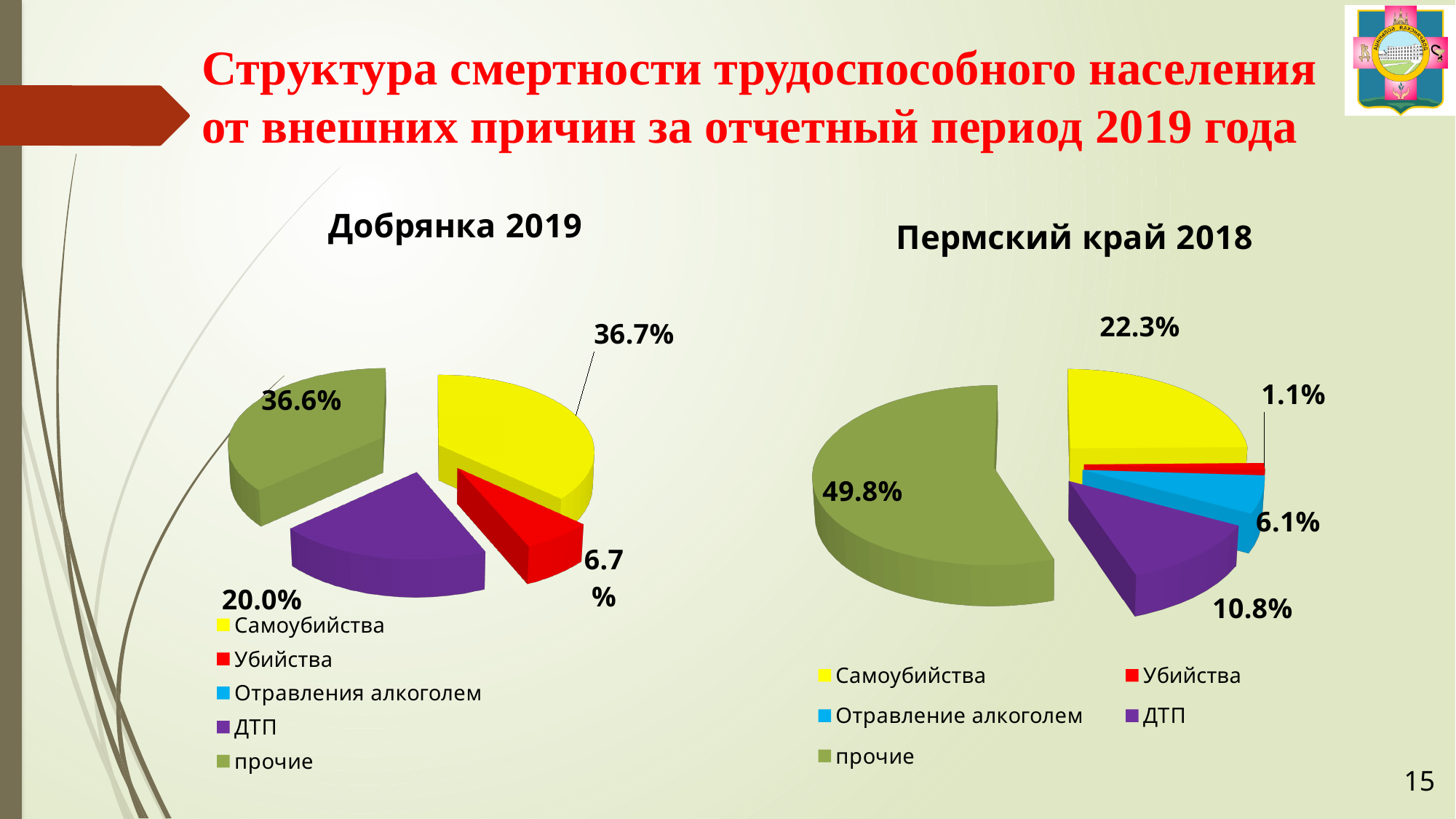
What type of chart is used for Добрянка 2019? Pie chart How many slices does the Пермский край 2018 pie chart have? 5 In the Добрянка 2019 chart, what share is labelled for the Убийства slice? 6.7% In the Пермский край 2018 chart, which category has the largest slice? прочие In the Пермский край 2018 chart, what is the difference between the Самоубийства share and the ДТП share? 11.5% In the Добрянка 2019 chart, what share is labelled for the ДТП slice? 20.0% In the Добрянка 2019 chart, what colour is the Самоубийства slice? Yellow In the Пермский край 2018 chart, what share is labelled for the Отравление алкоголем slice? 6.1% In the Добрянка 2019 chart, which is larger, the ДТП slice or the Убийства slice? ДТП In the Пермский край 2018 chart, which category has the smallest slice? Убийства In the Пермский край 2018 chart, what share is labelled for the прочие slice? 49.8% In the Добрянка 2019 chart, what share is labelled for the Самоубийства slice? 36.7%